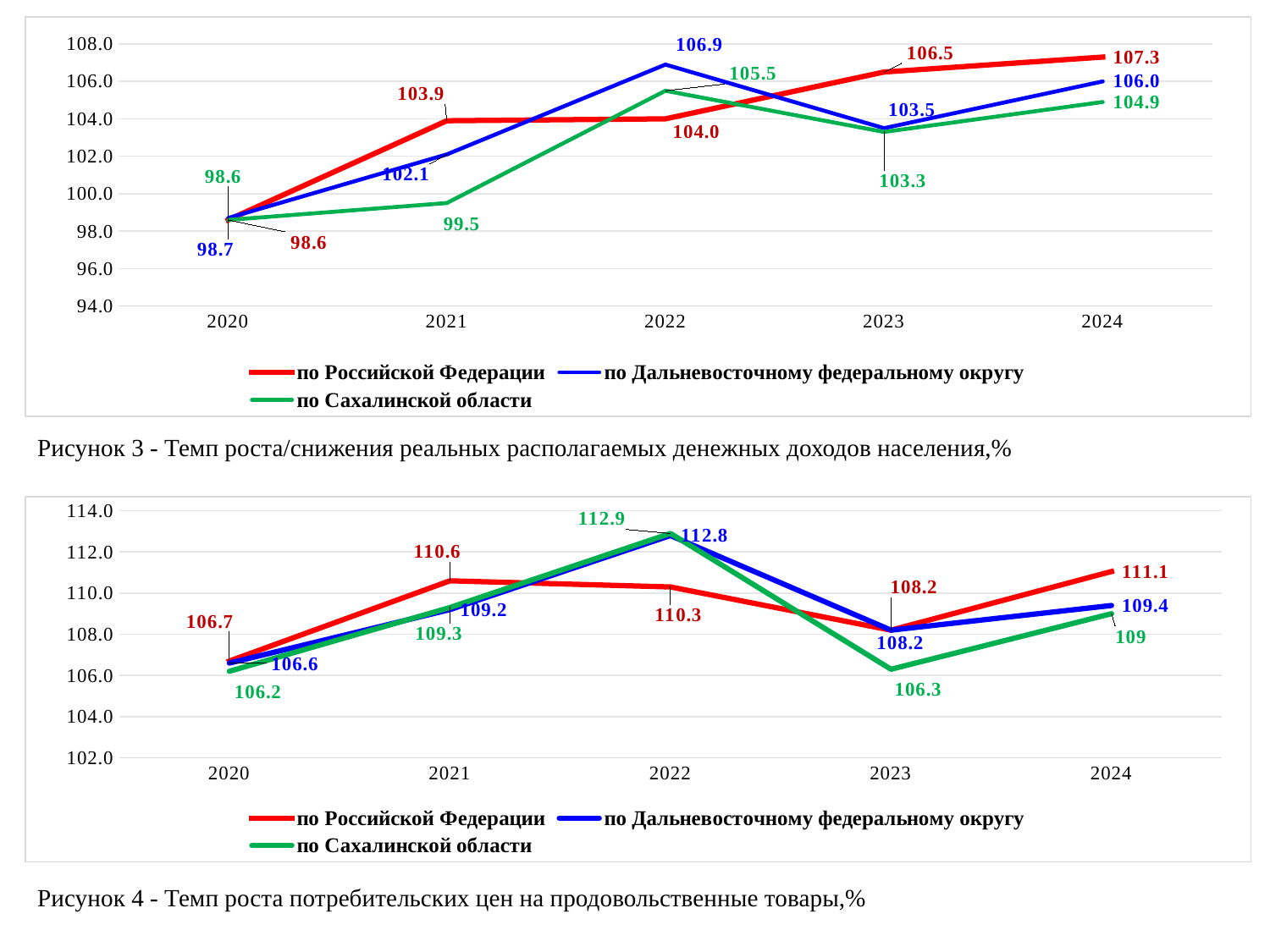
In the top chart (Рисунок 3), what is the value for по Российской Федерации in 2024? 107.3 How many series does the legend of the bottom chart (Рисунок 4) list? 3 In the top chart (Рисунок 3), how many years are shown on the x axis? 5 What type of chart is the bottom chart (Рисунок 4)? line chart In the bottom chart (Рисунок 4), in which year is the value for по Сахалинской области lowest? 2020 In the top chart (Рисунок 3), which series has the larger value in 2023: по Российской Федерации or по Сахалинской области? по Российской Федерации In the top chart (Рисунок 3), what is the difference between the 2022 values for по Дальневосточному федеральному округу and по Российской Федерации? 2.9 In the top chart (Рисунок 3), in which year is the value for по Дальневосточному федеральному округу highest? 2022 In the bottom chart (Рисунок 4), what is the value for по Сахалинской области in 2022? 112.9 In the top chart (Рисунок 3), what is the value for по Сахалинской области in 2021? 99.5 In the bottom chart (Рисунок 4), does the value for по Российской Федерации rise or fall from 2023 to 2024? rise In the bottom chart (Рисунок 4), what is the difference between the 2024 values for по Российской Федерации and по Сахалинской области? 2.1